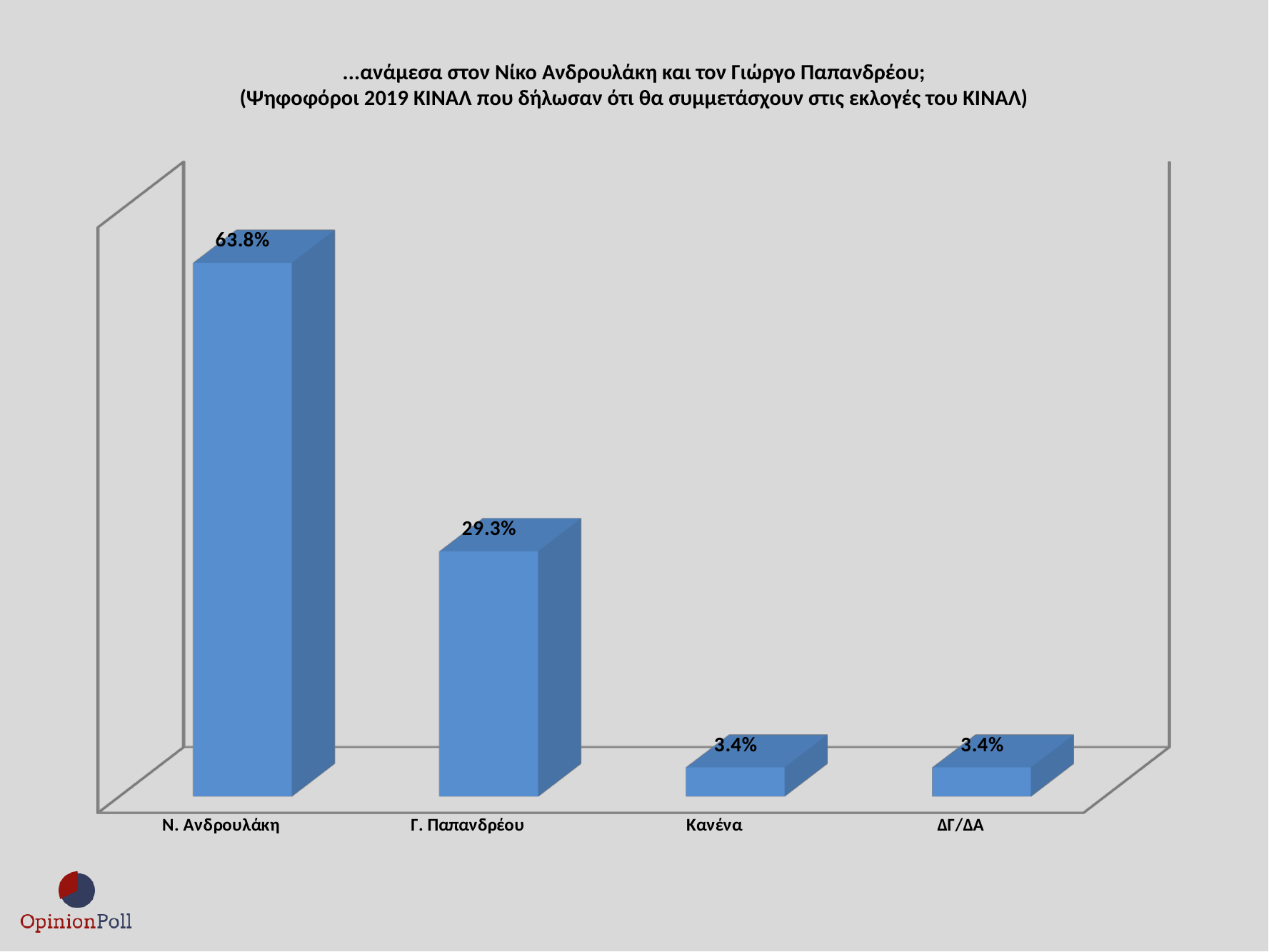
What is the difference between the values for Ν. Ανδρουλάκη and Γ. Παπανδρέου? 34.5% What kind of chart is shown on the slide? Bar chart What is the difference between the values for Γ. Παπανδρέου and ΔΓ/ΔΑ? 25.9% What is the label of the third category from the left? Κανένα How many categories are shown on the chart? 4 Which is larger, the value for Γ. Παπανδρέου or the value for Κανένα? Γ. Παπανδρέου What is the value for Γ. Παπανδρέου? 29.3% What is the value for Ν. Ανδρουλάκη? 63.8% Which category has the highest value? Ν. Ανδρουλάκη What is the value for Κανένα? 3.4% What colour are the bars in the chart? Blue What is the value for ΔΓ/ΔΑ? 3.4%